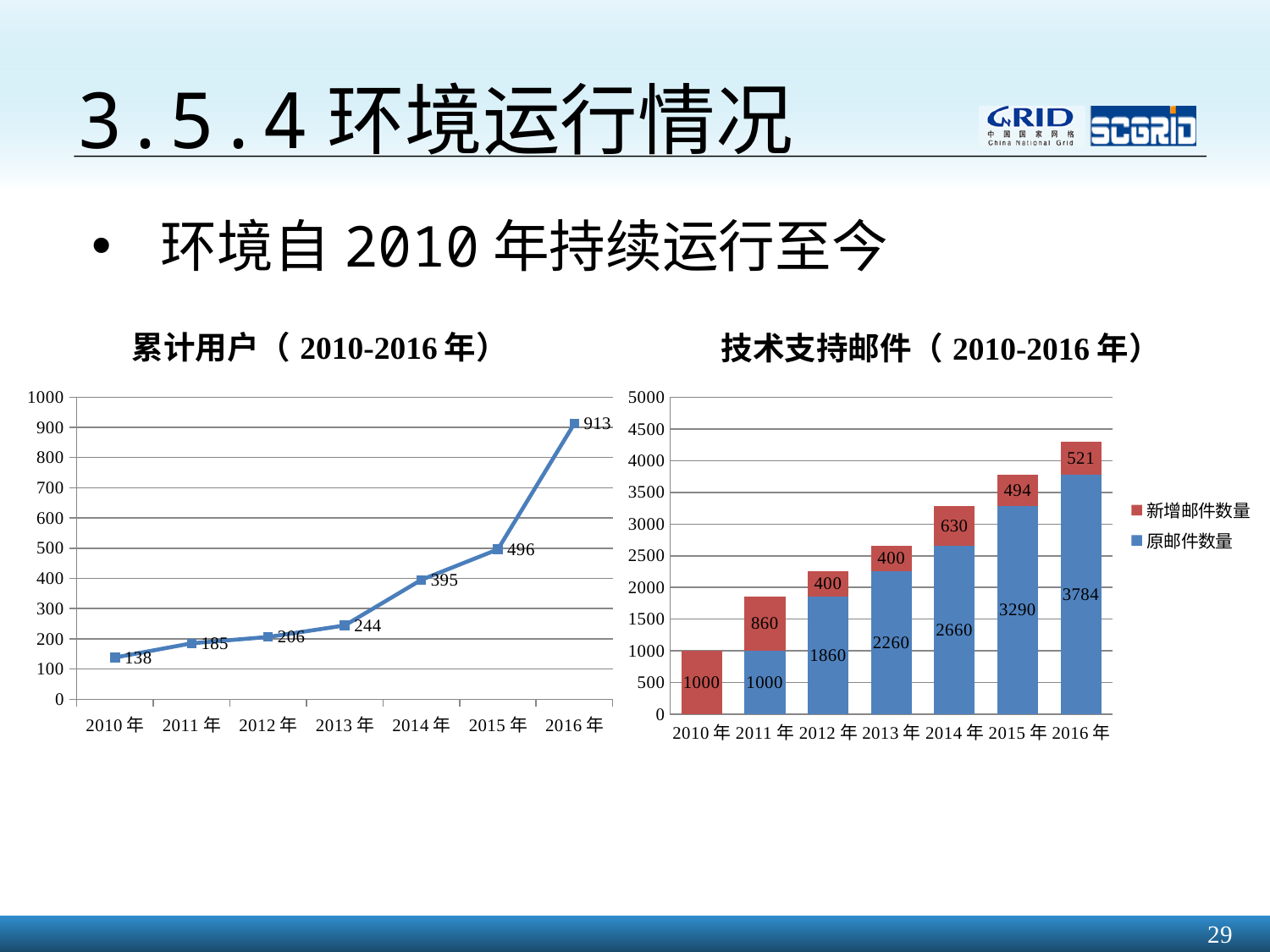
What kind of chart is the 累计用户（2010-2016年） chart? line chart In the 技术支持邮件（2010-2016年） chart, how many series does the legend list? 2 In the 累计用户（2010-2016年） chart, which year has the lowest value? 2010年 In the 技术支持邮件（2010-2016年） chart, what is the total of the stacked bar for 2016年? 4305 How many years are shown on the x axis of the 技术支持邮件（2010-2016年） chart? 7 In the 技术支持邮件（2010-2016年） chart, what is the 新增邮件数量 value for 2014年? 630 In the 技术支持邮件（2010-2016年） chart, what is the 原邮件数量 value for 2015年? 3290 In the 累计用户（2010-2016年） chart, do the values rise or fall from 2010年 to 2016年? rise In the 累计用户（2010-2016年） chart, what is the value for 2013年? 244 In the 累计用户（2010-2016年） chart, what is the value for 2016年? 913 In the 技术支持邮件（2010-2016年） chart, which is larger, the 新增邮件数量 value for 2011年 or for 2012年? 2011年 In the 累计用户（2010-2016年） chart, what is the difference between the values for 2016年 and 2015年? 417